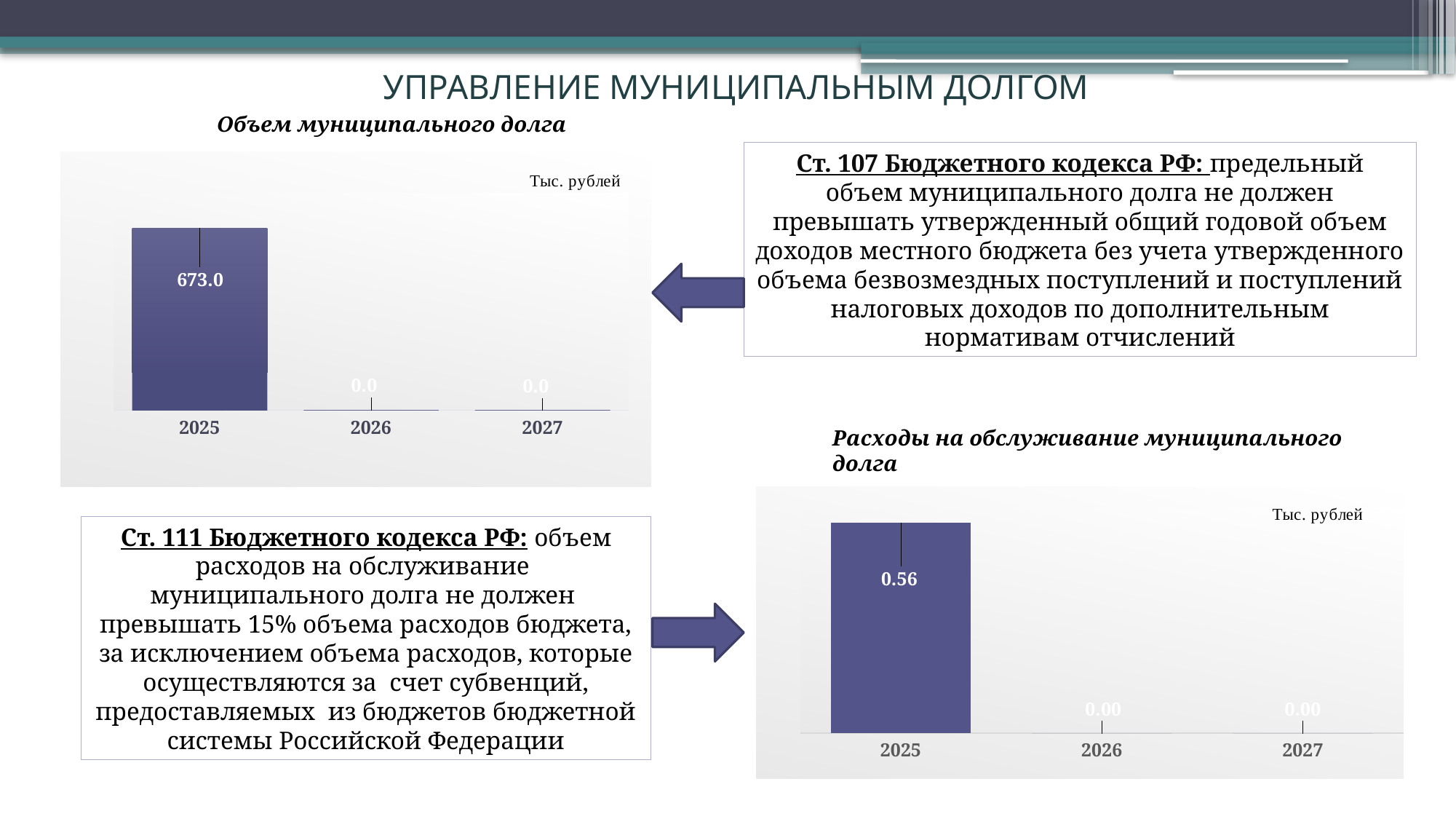
In the chart 'Расходы на обслуживание муниципального долга', what is the value for 2025? 0.56 In the chart 'Расходы на обслуживание муниципального долга', is the value for 2025 larger than the value for 2026? Yes In the chart 'Объем муниципального долга', what is the difference between the values for 2025 and 2027? 673.0 In the chart 'Объем муниципального долга', how many years are shown on the x axis? 3 What type of chart is 'Расходы на обслуживание муниципального долга'? Bar chart In the chart 'Расходы на обслуживание муниципального долга', which year has the highest value? 2025 In the chart 'Объем муниципального долга', what is the value for 2026? 0.0 In the chart 'Объем муниципального долга', do the values rise or fall from 2025 to 2027? Fall In the chart 'Объем муниципального долга', what is the value for 2025? 673.0 In the chart 'Объем муниципального долга', which year has the highest value? 2025 In the chart 'Объем муниципального долга', what unit is indicated in the top-right corner of the chart? Тыс. рублей In the chart 'Расходы на обслуживание муниципального долга', what is the value for 2027? 0.00